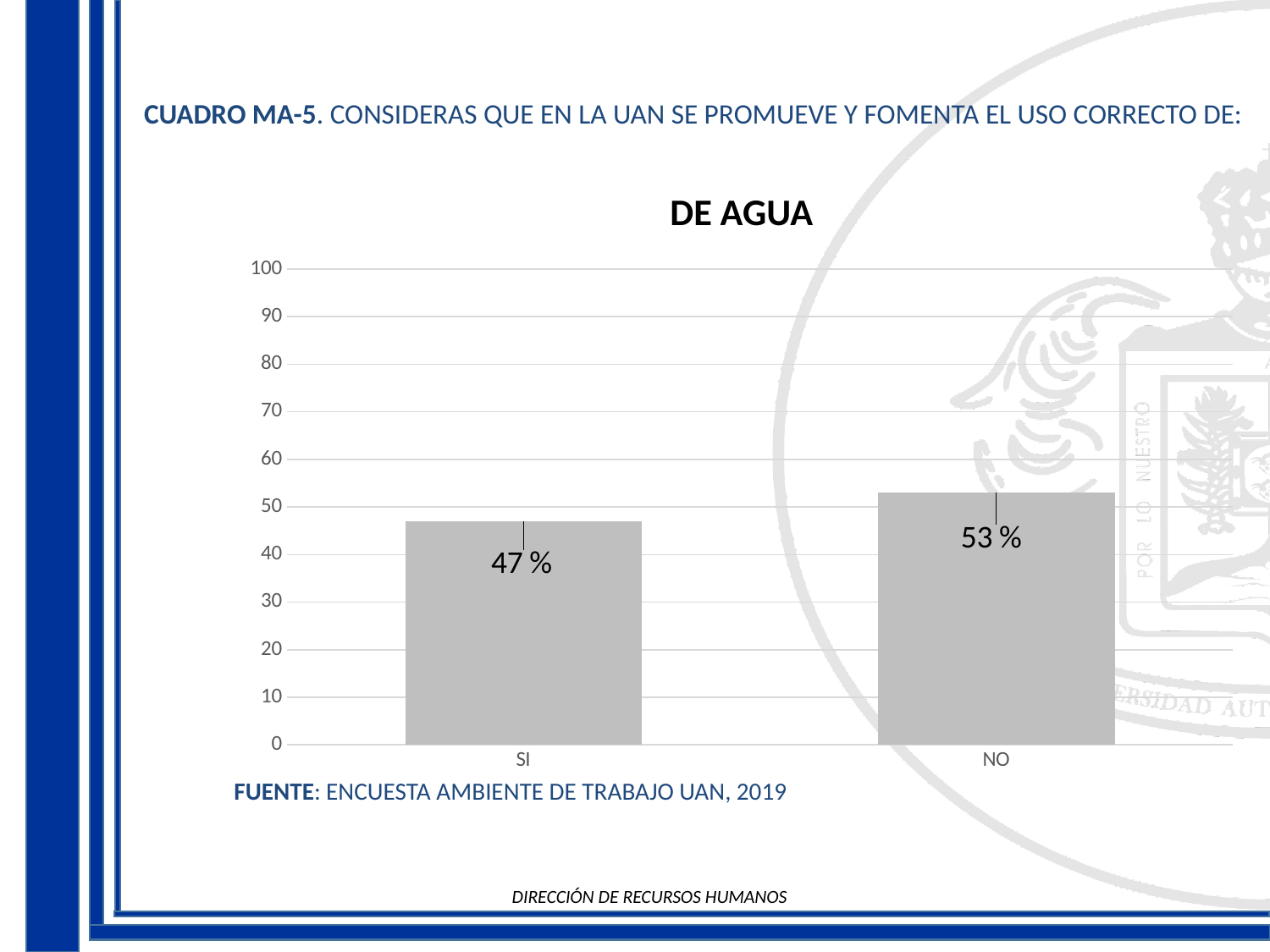
What is the difference between the values for NO and SI? 6 % Is the value for NO greater or less than 50? greater Which category has the highest value? NO What is the value for NO? 53 % What kind of chart is shown on the slide? bar chart How many categories are shown on the x axis? 2 What is the value for SI? 47 % What is the title of the chart? DE AGUA Which category has the lowest value? SI Is the value for SI greater or less than 50? less Which is larger, the value for SI or the value for NO? NO What is the highest value shown on the y axis? 100